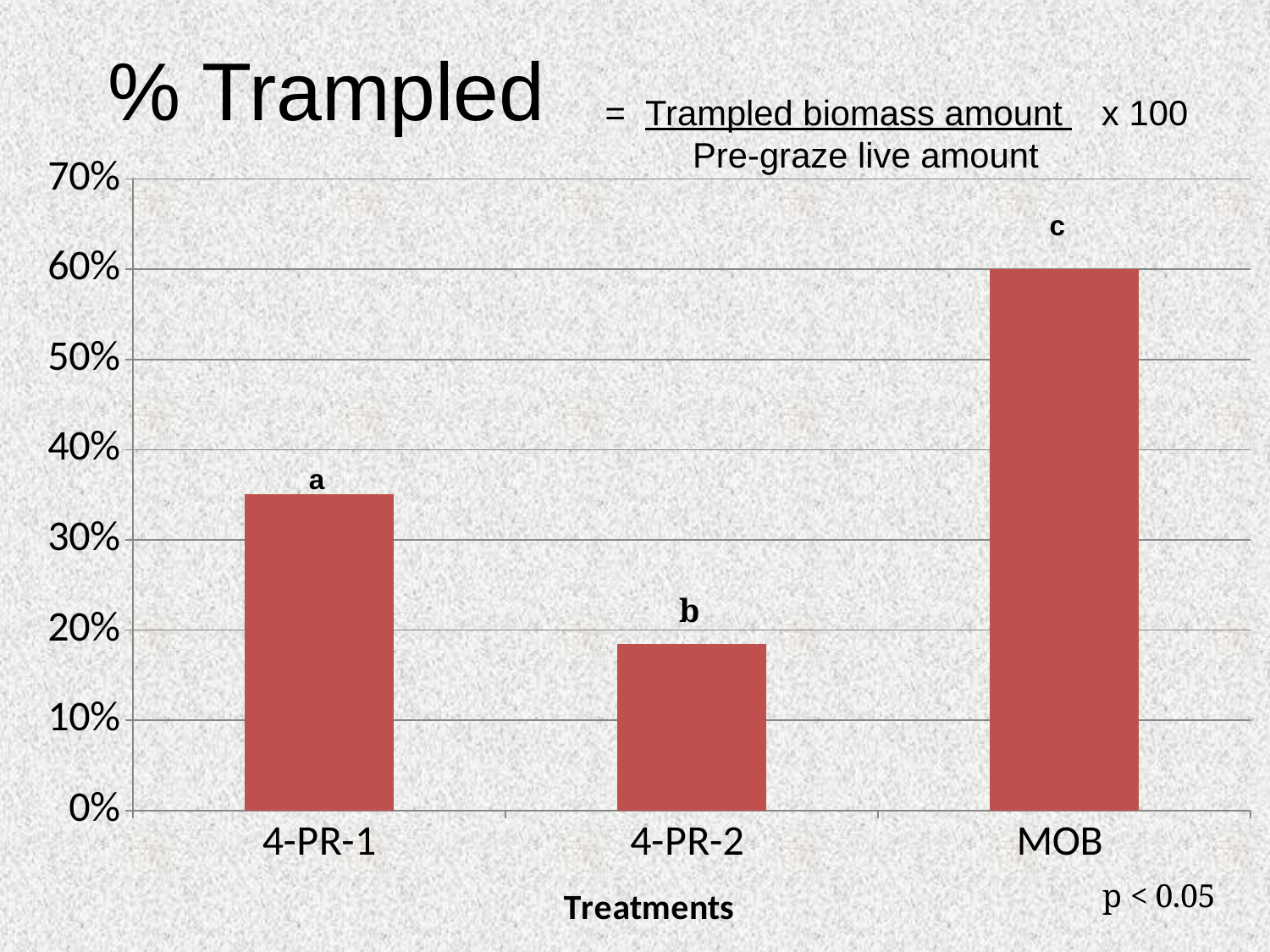
Which has a higher % Trampled, 4-PR-1 or 4-PR-2? 4-PR-1 What letter is printed above the MOB bar? c Is the value for 4-PR-1 greater or less than 40%? less How many treatments are plotted on the x axis? 3 Which has a higher % Trampled, 4-PR-1 or MOB? MOB Is the value for 4-PR-1 greater or less than 30%? greater What kind of chart is shown on the slide? bar chart Which treatment has the lowest % Trampled? 4-PR-2 Which treatment has the highest % Trampled? MOB What is the % Trampled value for MOB? 60% Is the value for 4-PR-2 greater or less than 20%? less What is the title of the x axis? Treatments